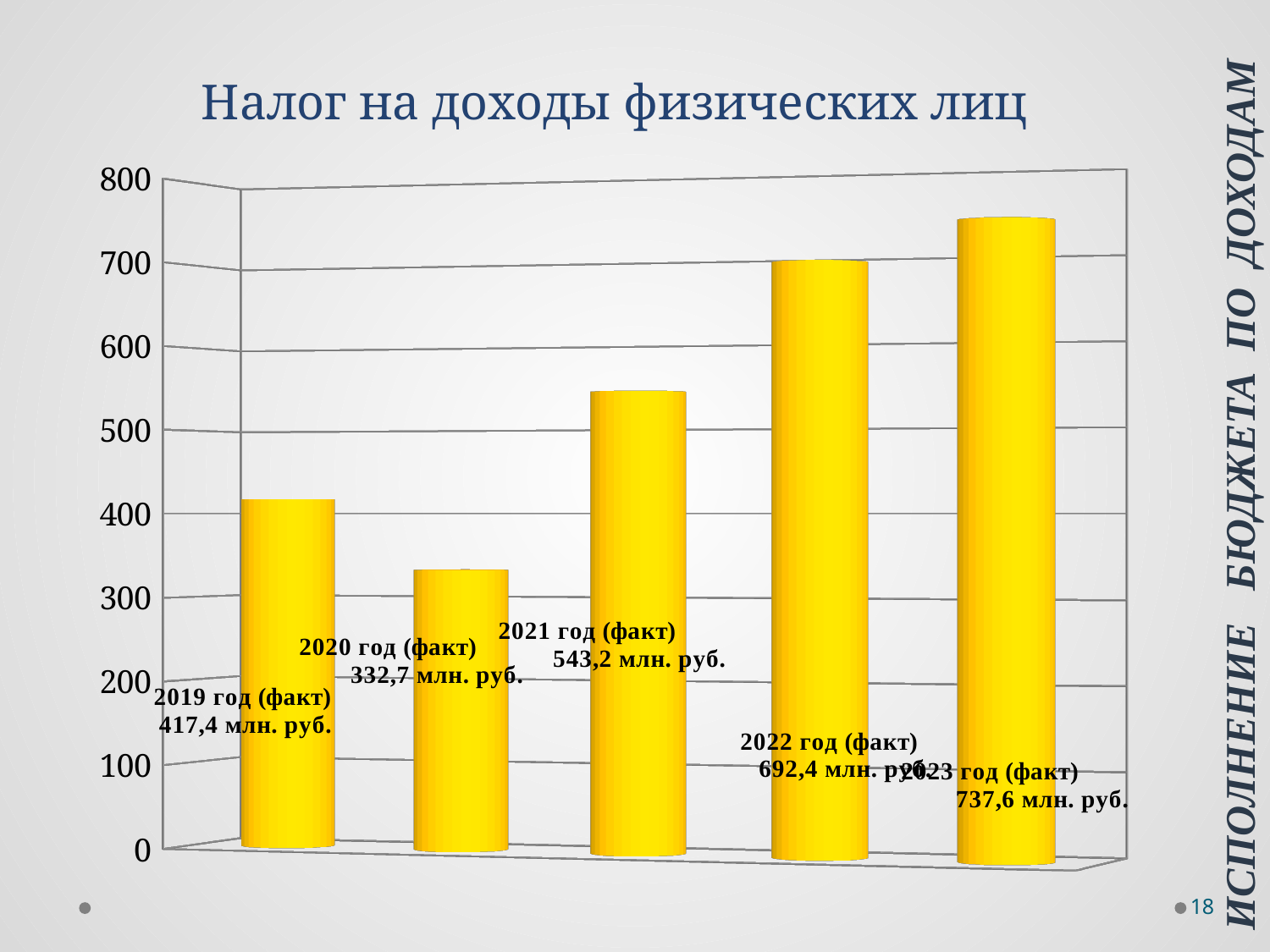
What is the value for 2019 год (факт)? 417,4 млн. руб. What is the title of the chart? Налог на доходы физических лиц What is the value for 2021 год (факт)? 543,2 млн. руб. Which year has the highest value? 2023 год (факт) What is the difference between the values for 2023 год (факт) and 2022 год (факт)? 45,2 млн. руб. What is the difference between the values for 2021 год (факт) and 2020 год (факт)? 210,5 млн. руб. Which is larger, the value for 2019 год (факт) or 2020 год (факт)? 2019 год (факт) What is the value for 2023 год (факт)? 737,6 млн. руб. Is the value for 2022 год (факт) greater or less than 600? greater Which year has the lowest value? 2020 год (факт) How many bars are shown in the chart? 5 What kind of chart is shown on the slide? bar chart